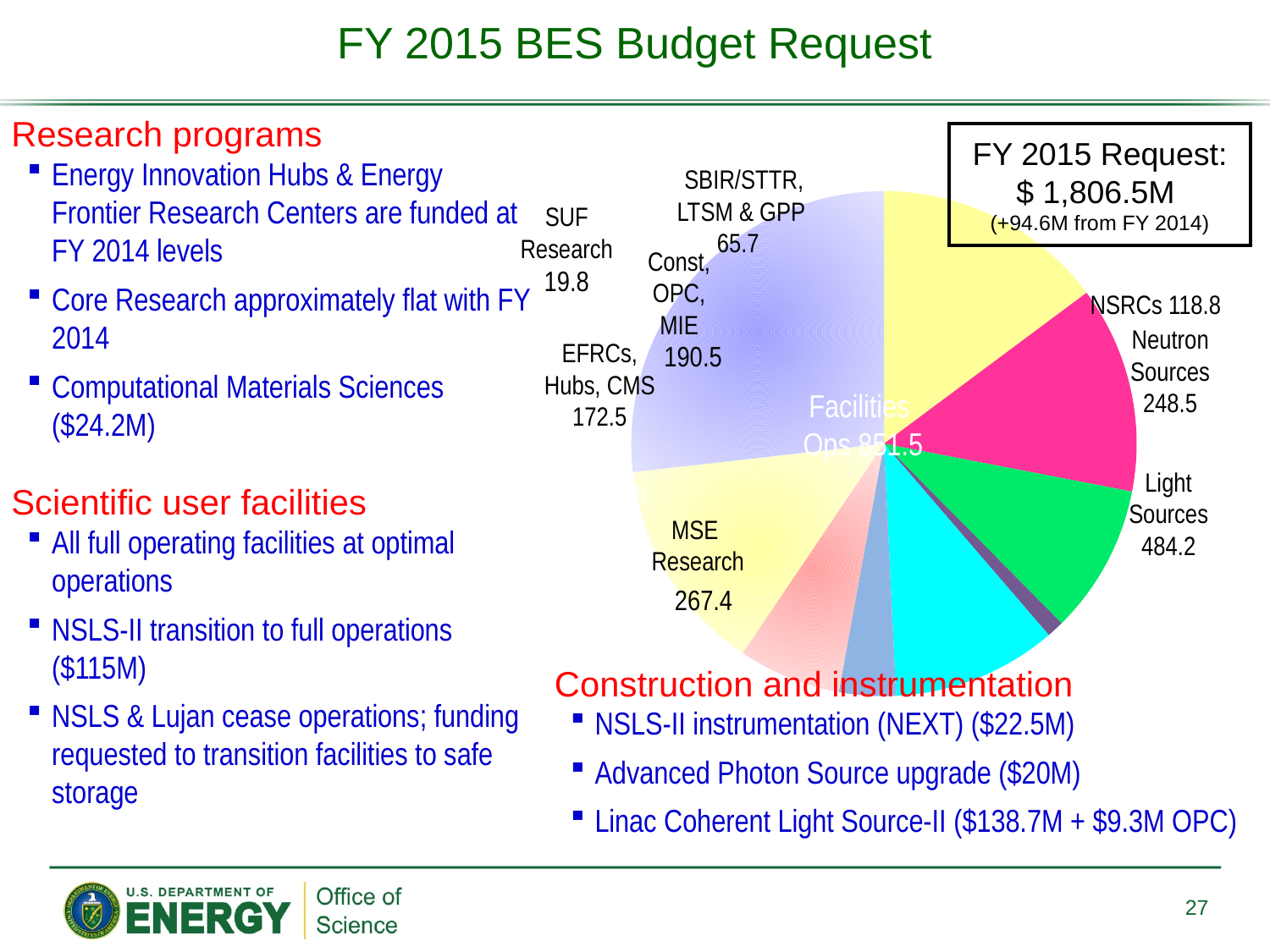
What is the value labelled for SBIR/STTR, LTSM & GPP in the pie chart? 65.7 What is the difference between the Light Sources value and the Neutron Sources value in the pie chart? 235.7 What total FY 2015 request amount is shown in the box next to the pie chart? $ 1,806.5M What is the value labelled for NSRCs in the pie chart? 118.8 What is the value labelled for EFRCs, Hubs, CMS in the pie chart? 172.5 What is the value labelled for MSE Research in the pie chart? 267.4 What is the value labelled for Neutron Sources in the pie chart? 248.5 What is the value labelled for Light Sources in the pie chart? 484.2 Which is larger in the pie chart, Light Sources or Neutron Sources? Light Sources What kind of chart is shown on the slide? pie chart Which labelled category in the pie chart has the smallest value? SUF Research What is the value labelled for Const, OPC, MIE in the pie chart? 190.5